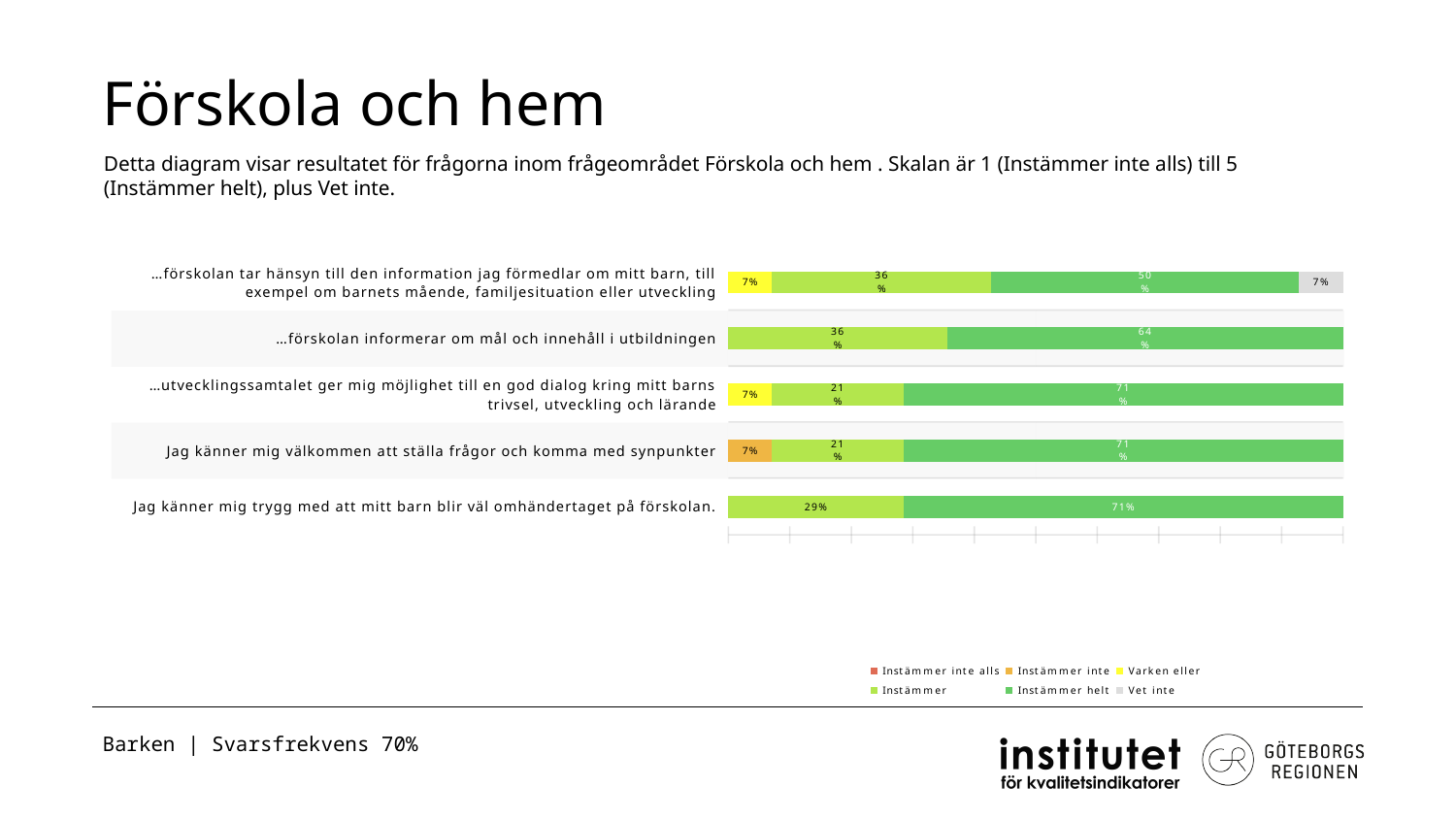
What is the 'Instämmer' value for 'Jag känner mig trygg med att mitt barn blir väl omhändertaget på förskolan.'? 29% How many statements (categories) are plotted in the chart? 5 What is the 'Instämmer helt' value for '…förskolan tar hänsyn till den information jag förmedlar om mitt barn, till exempel om barnets mående, familjesituation eller utveckling'? 50% What is the 'Vet inte' value for '…förskolan tar hänsyn till den information jag förmedlar om mitt barn, till exempel om barnets mående, familjesituation eller utveckling'? 7% What is the title of the slide containing the chart? Förskola och hem What is the 'Instämmer inte' value for 'Jag känner mig välkommen att ställa frågor och komma med synpunkter'? 7% How many series does the legend list? 6 Which is larger: the 'Instämmer' value for '…förskolan informerar om mål och innehåll i utbildningen' or for 'Jag känner mig trygg med att mitt barn blir väl omhändertaget på förskolan.'? …förskolan informerar om mål och innehåll i utbildningen What is the 'Instämmer helt' value for '…förskolan informerar om mål och innehåll i utbildningen'? 64% What kind of chart is shown on the slide? Stacked bar chart Which statement has the lowest 'Instämmer helt' value? …förskolan tar hänsyn till den information jag förmedlar om mitt barn, till exempel om barnets mående, familjesituation eller utveckling What is the difference between the 'Instämmer helt' values for '…förskolan informerar om mål och innehåll i utbildningen' and '…förskolan tar hänsyn till den information jag förmedlar om mitt barn, till exempel om barnets mående, familjesituation eller utveckling'? 14%